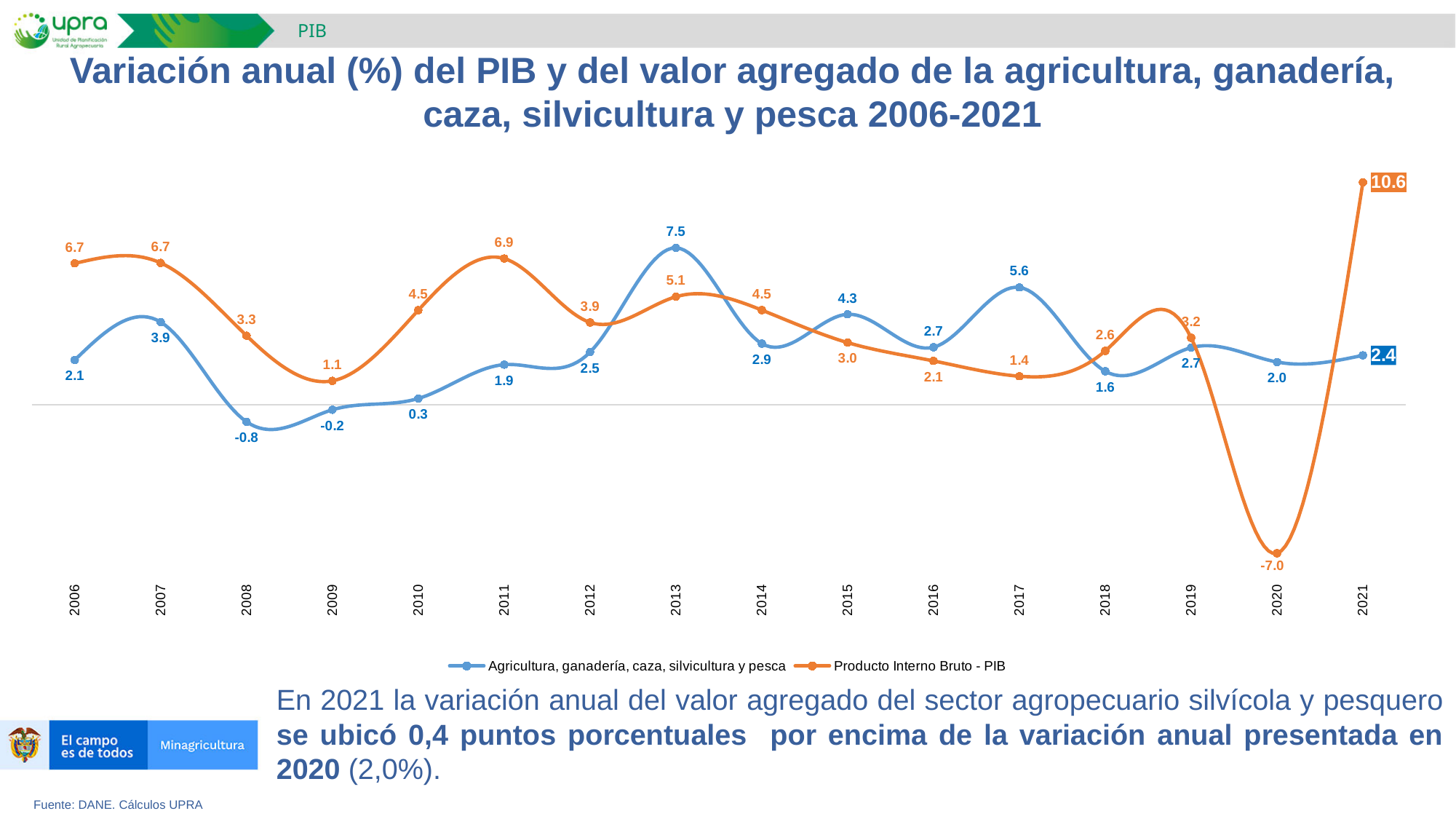
What type of chart is shown on the slide? Line chart Does the Producto Interno Bruto - PIB series rise or fall from 2020 to 2021? Rise Which series has the larger value in 2017, Agricultura, ganadería, caza, silvicultura y pesca or Producto Interno Bruto - PIB? Agricultura, ganadería, caza, silvicultura y pesca How many years are plotted on the x axis? 16 What is the value for Producto Interno Bruto - PIB in 2020? -7.0 How many series does the legend list? 2 In which year does the Agricultura, ganadería, caza, silvicultura y pesca series reach its highest value? 2013 What is the value for Producto Interno Bruto - PIB in 2021? 10.6 In which year does the Producto Interno Bruto - PIB series reach its lowest value? 2020 What is the value for Agricultura, ganadería, caza, silvicultura y pesca in 2013? 7.5 What is the difference between the Agricultura, ganadería, caza, silvicultura y pesca values in 2021 and 2020? 0.4 Which colour is used for the Producto Interno Bruto - PIB line? Orange